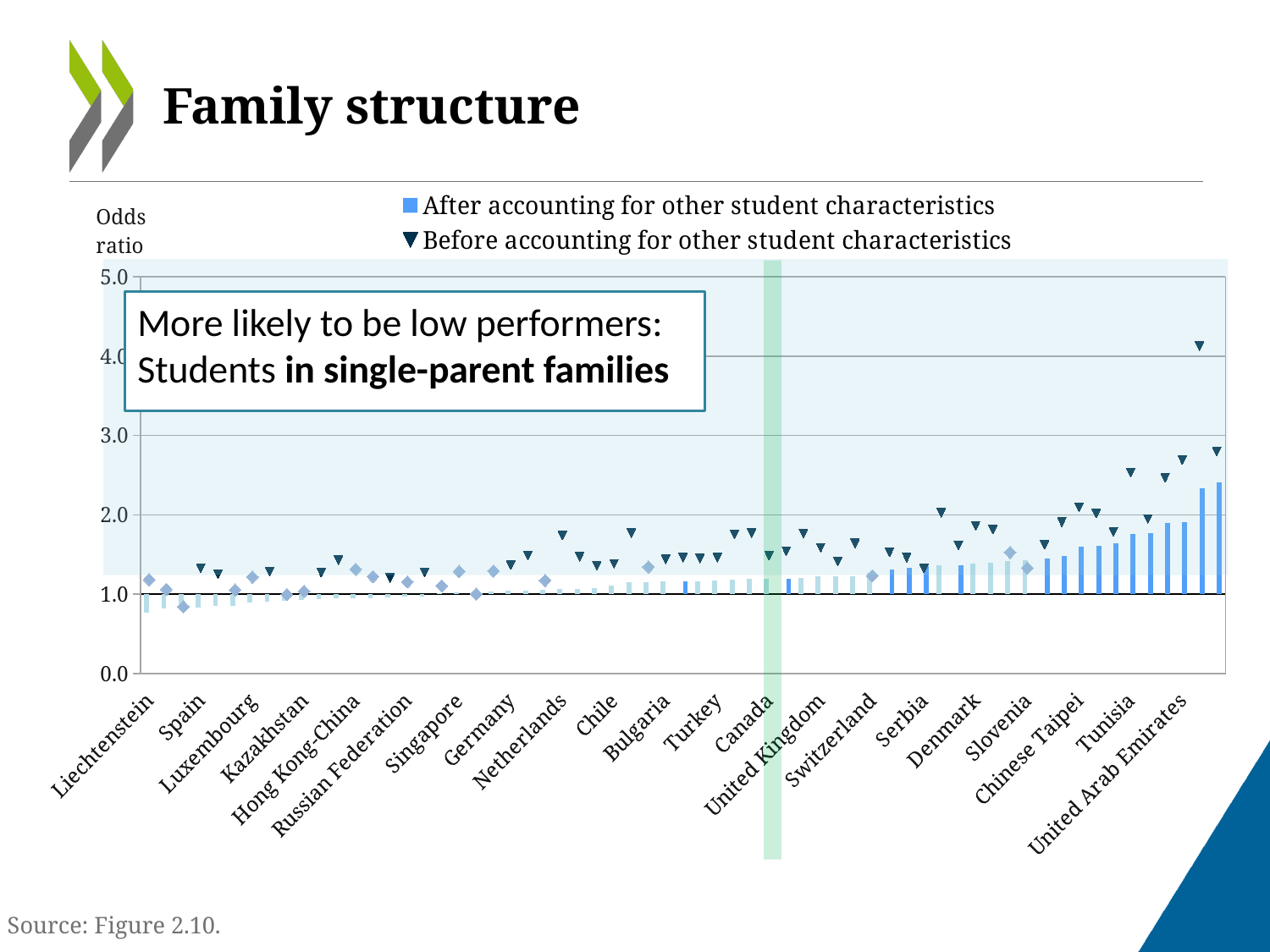
Which labelled country has the highest 'Before accounting for other student characteristics' value? United Arab Emirates What are the two series named in the legend? After accounting for other student characteristics; Before accounting for other student characteristics How many series does the legend list? 2 Is the highest 'Before accounting for other student characteristics' value greater or less than 4.0? greater Is the 'After accounting for other student characteristics' value for Liechtenstein greater or less than 1.0? less Which is larger for United Arab Emirates: the 'Before accounting' value or the 'After accounting' value? Before accounting for other student characteristics What is the label on the vertical axis? Odds ratio What is the highest value shown on the vertical axis? 5.0 Is the 'After accounting for other student characteristics' value for Tunisia greater or less than 1.0? greater What kind of chart is shown on the slide? Bar chart Do the 'After accounting for other student characteristics' bars generally rise or fall from left to right along the x axis? Rise